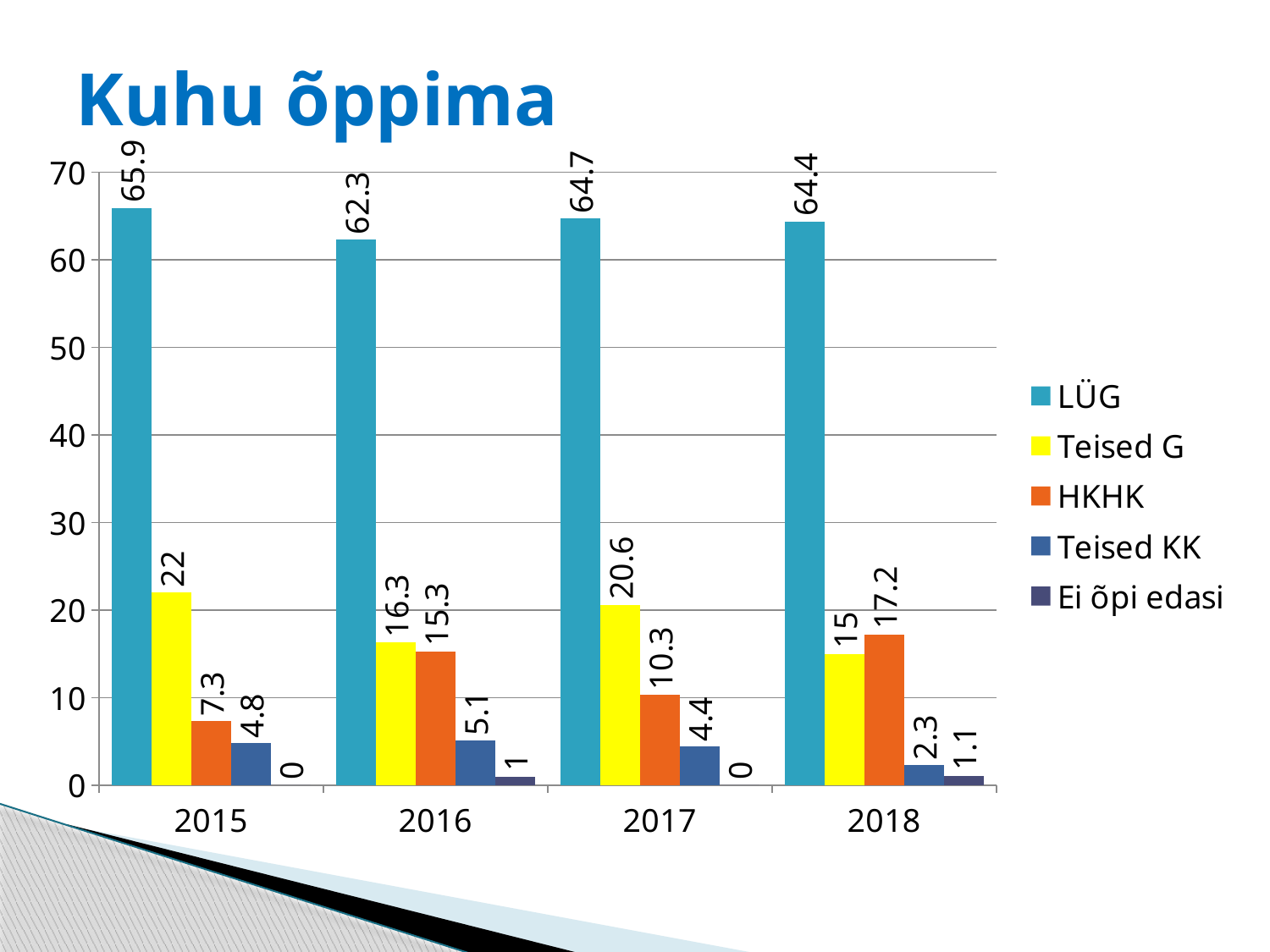
In which year is the LÜG value lowest? 2016 What is the value for LÜG in 2015? 65.9 Which is larger in 2016: Teised G or HKHK? Teised G What is the value for Teised KK in 2017? 4.4 What is the difference between the HKHK values in 2018 and 2017? 6.9 What kind of chart is shown on the slide? bar chart What is the value for HKHK in 2018? 17.2 Is the value for LÜG in 2017 greater or less than 60? greater What is the title of the slide? Kuhu õppima In which year is the Teised G value highest? 2015 How many series does the legend list? 5 How many years are shown on the x axis? 4